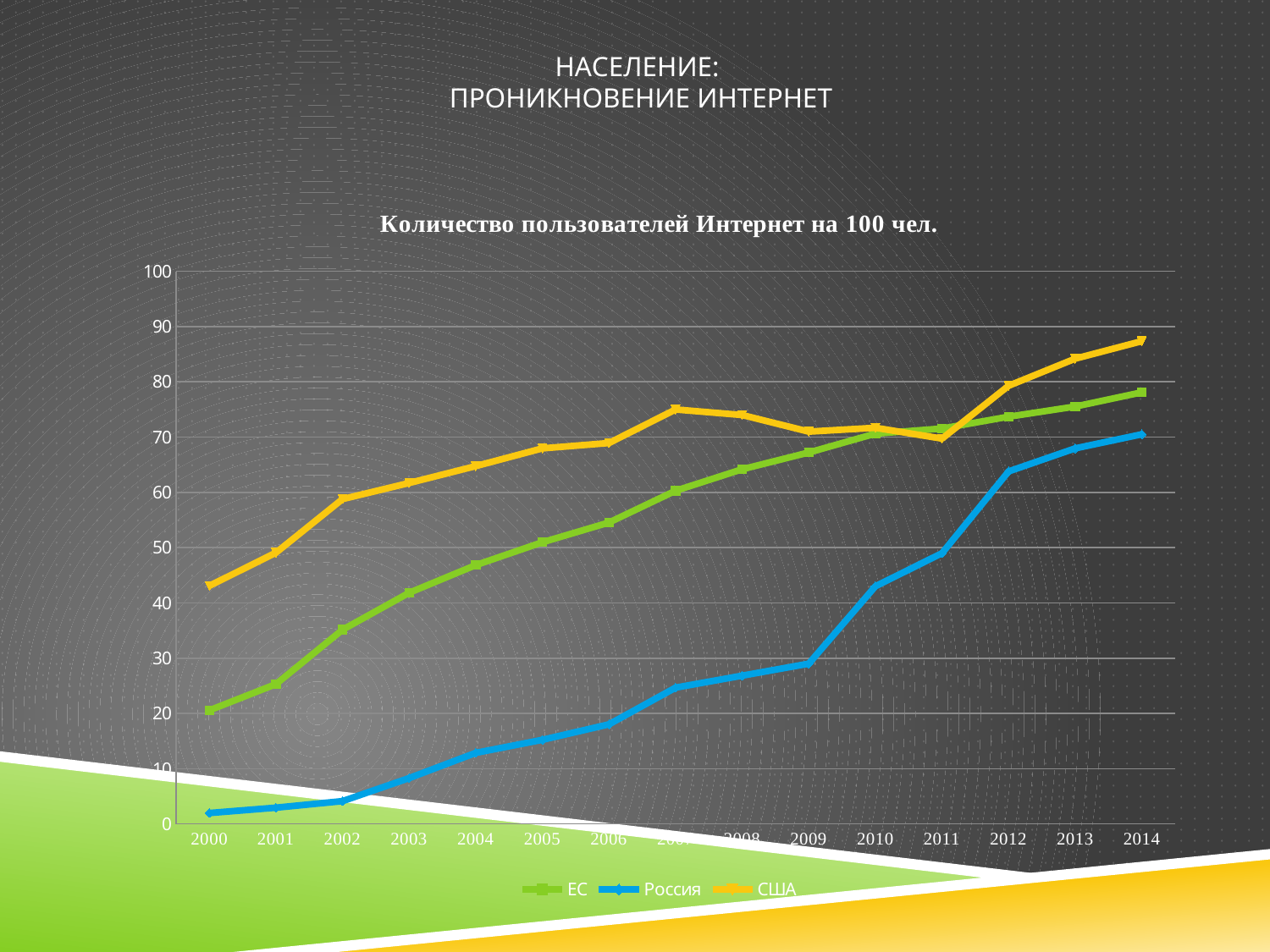
What kind of chart is shown on the slide? line chart Which series is drawn in blue? Россия What is the title of the chart? Количество пользователей Интернет на 100 чел. How many series does the legend list? 3 How many years are shown on the x axis? 15 Is the value for Россия in 2000 greater or less than 10? less Does the value for Россия rise or fall from 2000 to 2014? rise Which series has the highest value in 2014? США Is the value for США in 2014 greater or less than 80? greater Which is larger in 2014, the value for ЕС or the value for Россия? ЕС Which series has the lowest value in 2000? Россия